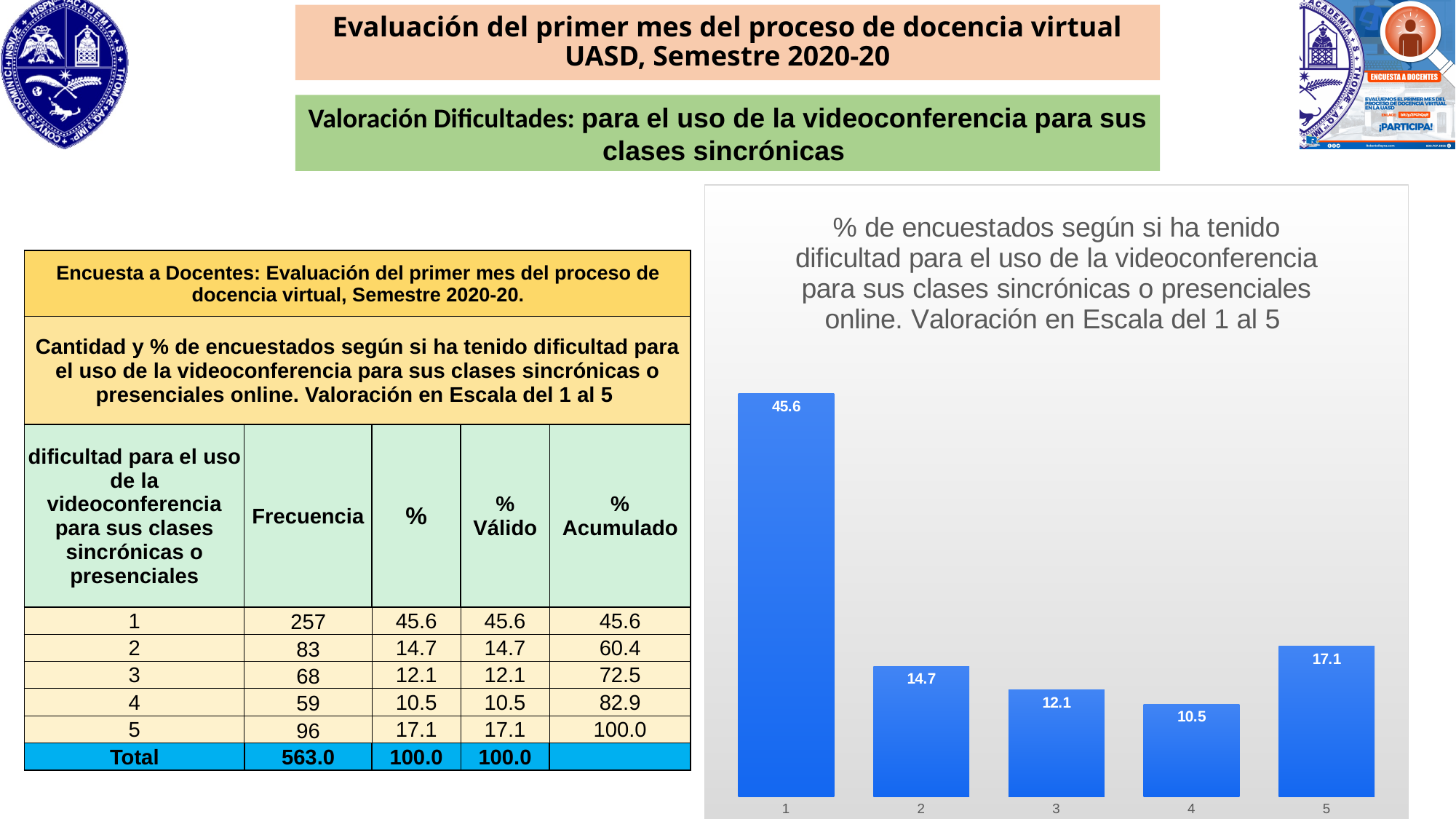
What is the value for category 5 in the bar chart? 17.1 What is the value for category 3 in the bar chart? 12.1 What kind of chart is shown on the slide? bar chart How many categories are shown on the x axis of the bar chart? 5 What is the value for category 1 in the bar chart? 45.6 What colour are the bars in the chart? blue Do the values in the bar chart rise or fall from category 1 to category 4? fall Which is larger in the bar chart, the value for category 2 or the value for category 5? 5 What is the difference between the values for category 1 and category 2 in the bar chart? 30.9 Which category has the highest value in the bar chart? 1 Which category has the lowest value in the bar chart? 4 What is the difference between the values for category 5 and category 4 in the bar chart? 6.6